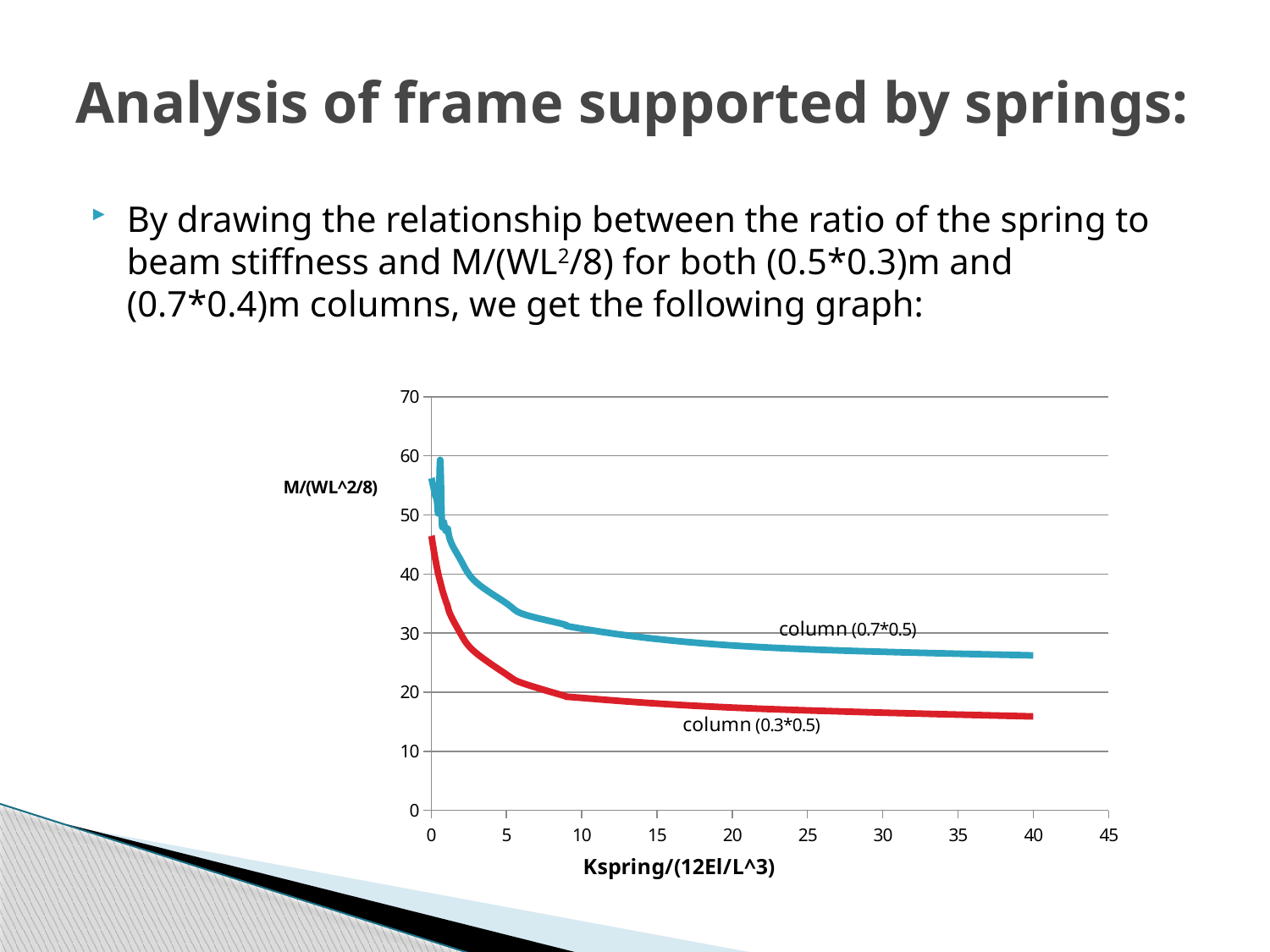
Is the value for column (0.3*0.5) at Kspring/(12EI/L^3) = 40 greater or less than 20? less What colour is the line for the column (0.3*0.5) series? red Is the value for column (0.3*0.5) at Kspring/(12EI/L^3) = 40 greater or less than 10? greater Do the values of the column (0.7*0.5) series rise or fall as Kspring/(12EI/L^3) increases? fall What kind of chart is shown on the slide? line chart Which series has the higher M/(WL^2/8) value at Kspring/(12EI/L^3) = 40, column (0.7*0.5) or column (0.3*0.5)? column (0.7*0.5) How many series are plotted on the chart? 2 What is the label of the x-axis of the chart? Kspring/(12EI/L^3) Is the value for column (0.7*0.5) at Kspring/(12EI/L^3) = 40 greater or less than 30? less Which series lies higher on the chart across the whole x-axis range? column (0.7*0.5) Do the values of the column (0.3*0.5) series rise or fall as Kspring/(12EI/L^3) increases? fall